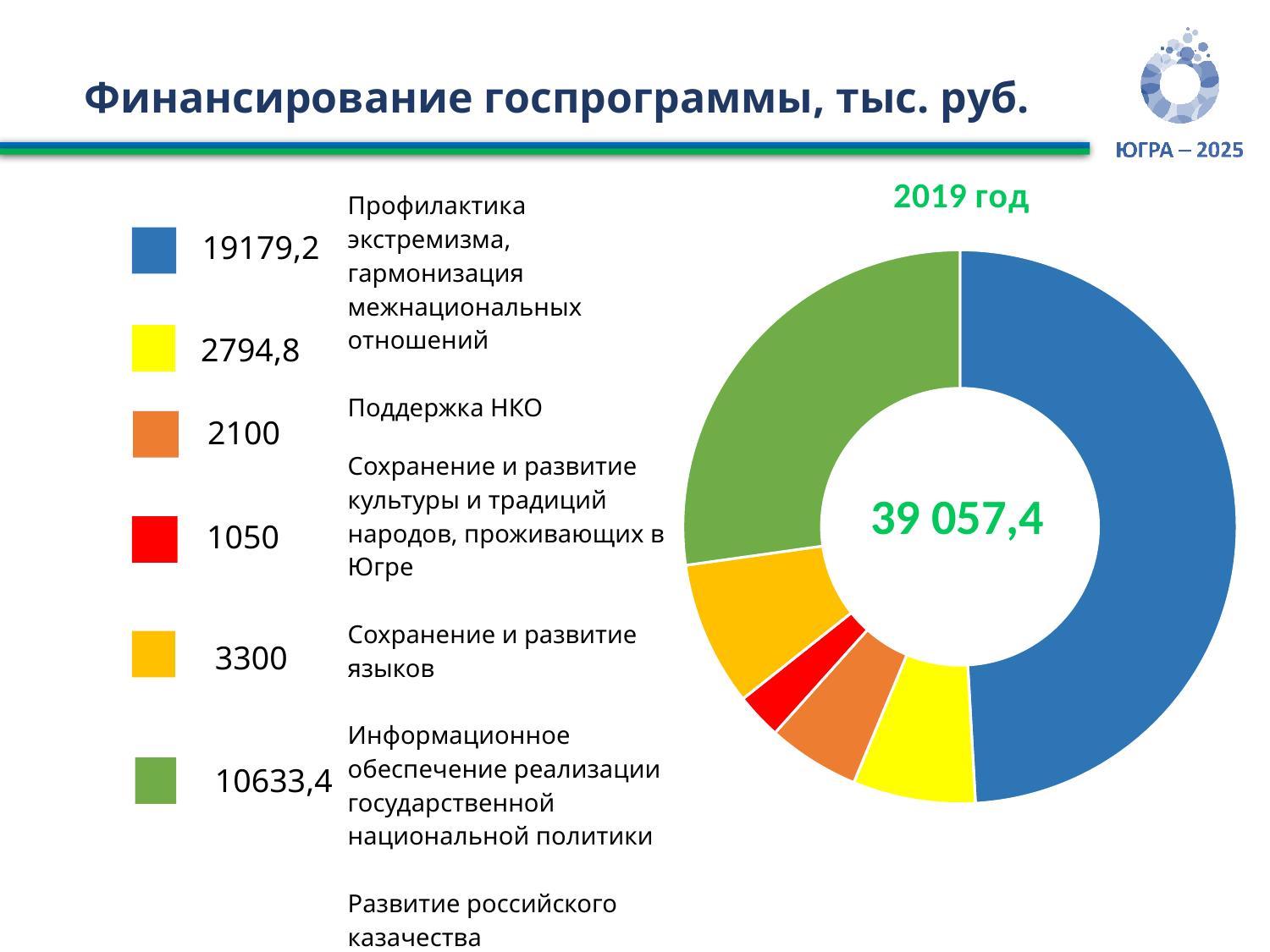
What value does the yellow segment of the chart represent? 2794,8 Which year does the chart refer to? 2019 год Which segment has the largest value? Blue (19179,2) How many segments does the donut chart have? 6 What is the difference between the blue segment (19179,2) and the green segment (10633,4)? 8545,8 Which is larger, the amber segment (3300) or the orange segment (2100)? Amber (3300) What value does the red segment of the chart represent? 1050 Which segment has the smallest value? Red (1050) What is the total value shown in the centre of the donut chart? 39 057,4 What type of chart is shown on the slide? Donut (pie) chart What value does the blue segment of the chart represent? 19179,2 What value does the green segment of the chart represent? 10633,4